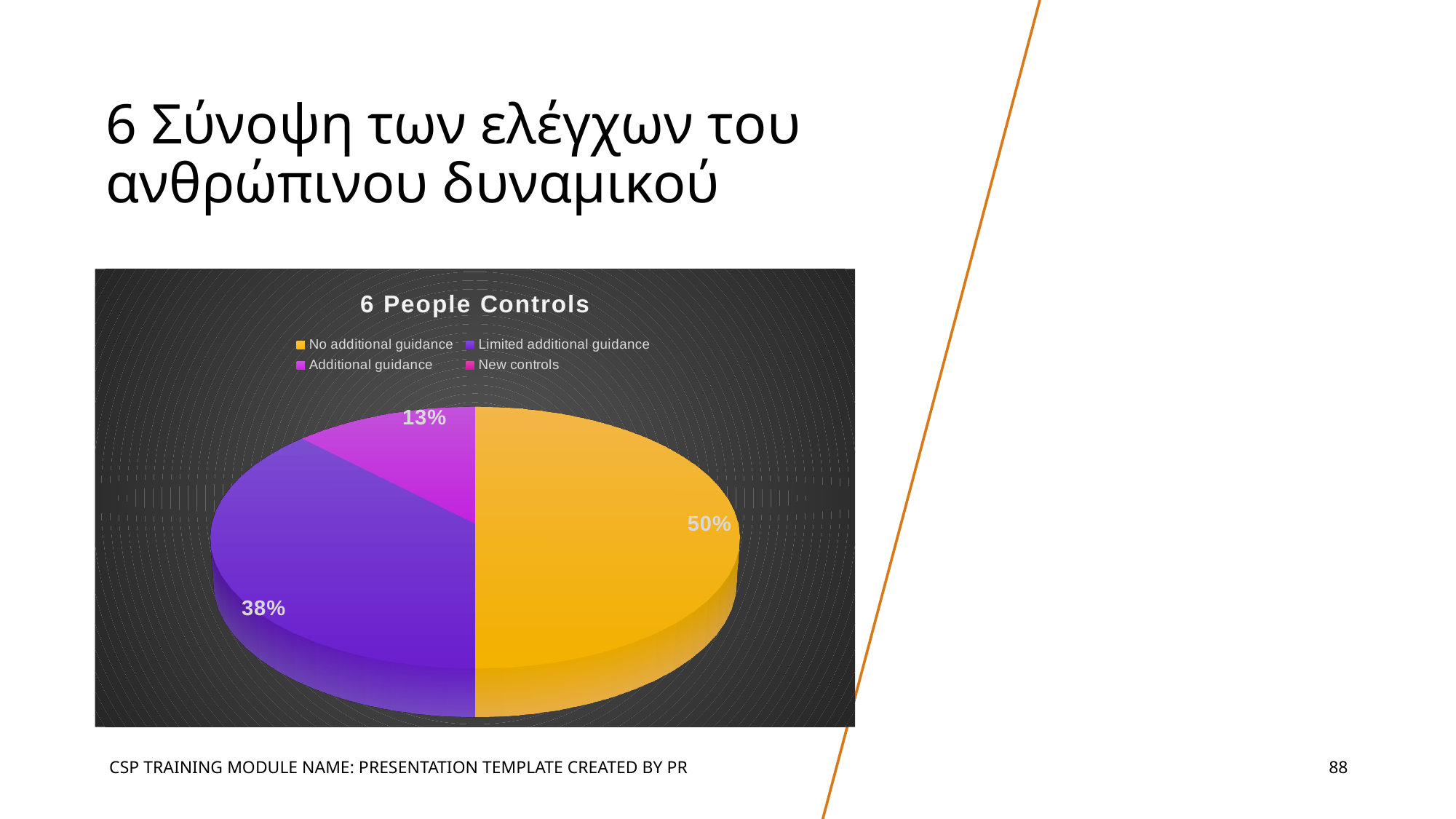
Which slice is larger: Limited additional guidance or Additional guidance? Limited additional guidance What percentage of the pie is labelled for No additional guidance? 50% Which category has the largest slice of the pie? No additional guidance What is the difference in percentage points between the No additional guidance slice and the Limited additional guidance slice? 12 What percentage of the pie is labelled for Limited additional guidance? 38% Of the three slices with percentage labels, which category has the smallest share? Additional guidance What percentage of the pie is labelled for Additional guidance? 13% What type of chart is shown on the slide? pie chart What colour is the No additional guidance slice? orange What share of the pie does the Limited additional guidance slice represent? 38% How many entries does the chart legend list? 4 What is the title of the chart? 6 People Controls